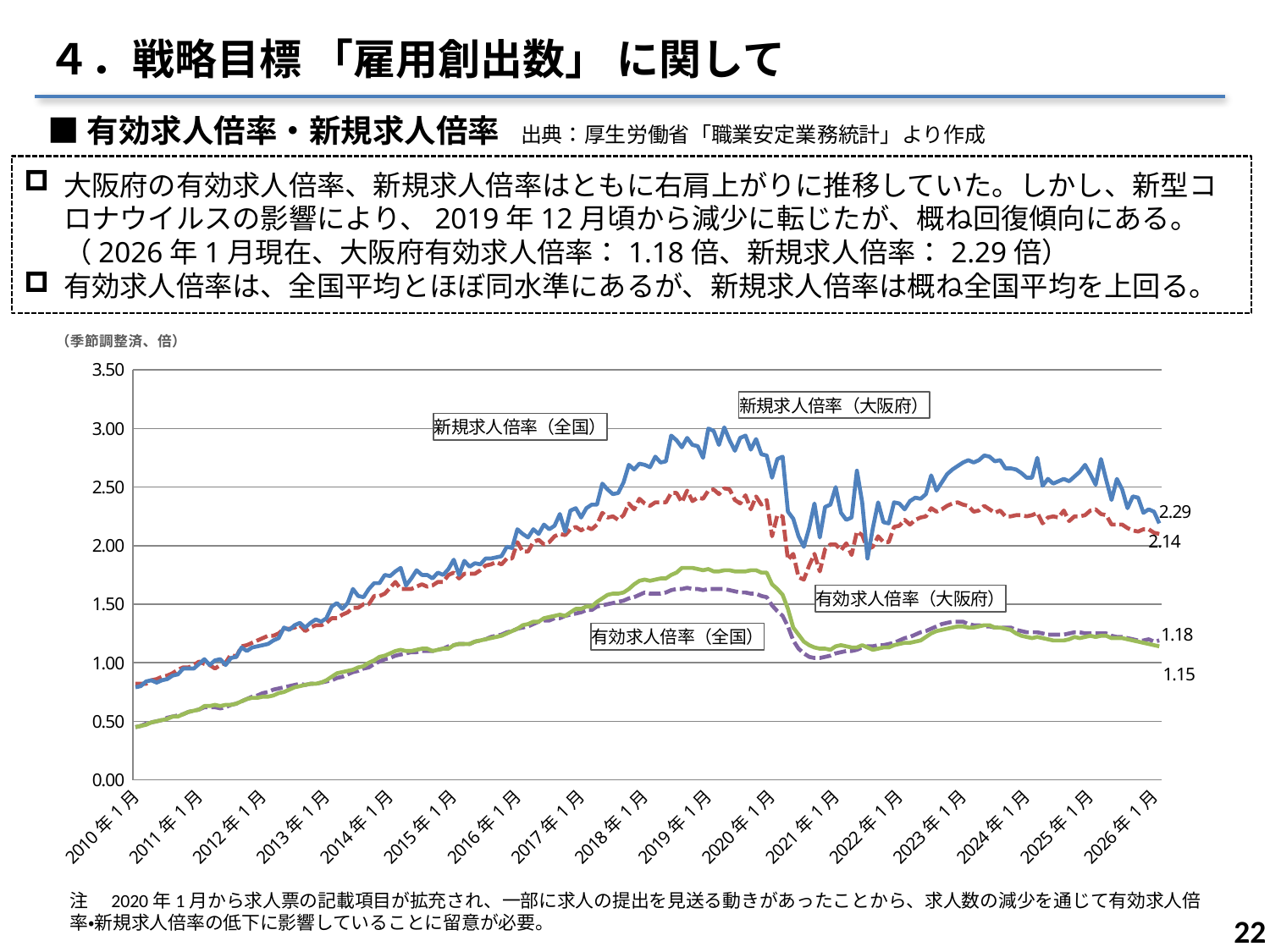
How many series are plotted in the chart? 4 What is the value printed at the end of the 新規求人倍率（全国） line in the chart? 2.14 Is the value of 新規求人倍率（大阪府） at 2010年1月 greater or less than 1.00? less What kind of chart is shown on the slide? line chart Which of the four series has the highest value at the right end of the chart? 新規求人倍率（大阪府） What is the difference between the final printed values of 新規求人倍率（大阪府） (2.29) and 新規求人倍率（全国） (2.14)? 0.15 Is the value of 有効求人倍率（大阪府） around 2019年1月 greater or less than 1.50? greater At the end of the chart, which is larger: 新規求人倍率（大阪府） or 新規求人倍率（全国）? 新規求人倍率（大阪府） What is the value printed at the end of the 新規求人倍率（大阪府） line in the chart? 2.29